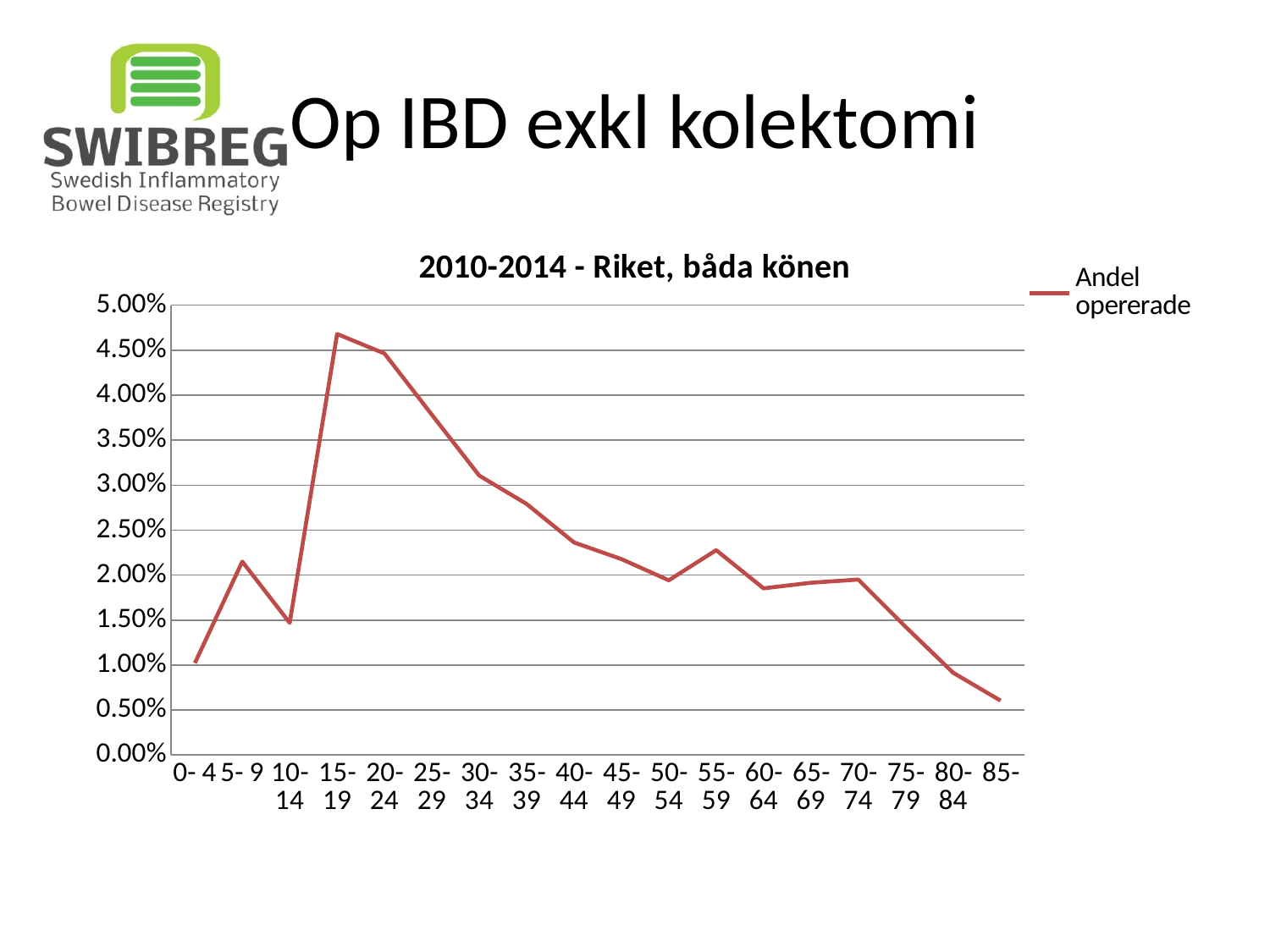
What kind of chart is shown on the slide? line chart Is the value for the 85- age group greater or less than 1.00%? less How many series does the legend list? 1 How many age groups are plotted along the x axis? 18 What is the name of the series shown in the legend? Andel opererade Do the values rise or fall from the 20-24 age group to the 50-54 age group? fall What is the title of the chart? 2010-2014 - Riket, båda könen Which age group has the highest value for Andel opererade? 15-19 Is the value for the 40-44 age group greater or less than 3.00%? less Which has the larger value, the 5-9 age group or the 10-14 age group? 5-9 Which age group has the lowest value for Andel opererade? 85- Is the value for the 15-19 age group greater or less than 4.00%? greater